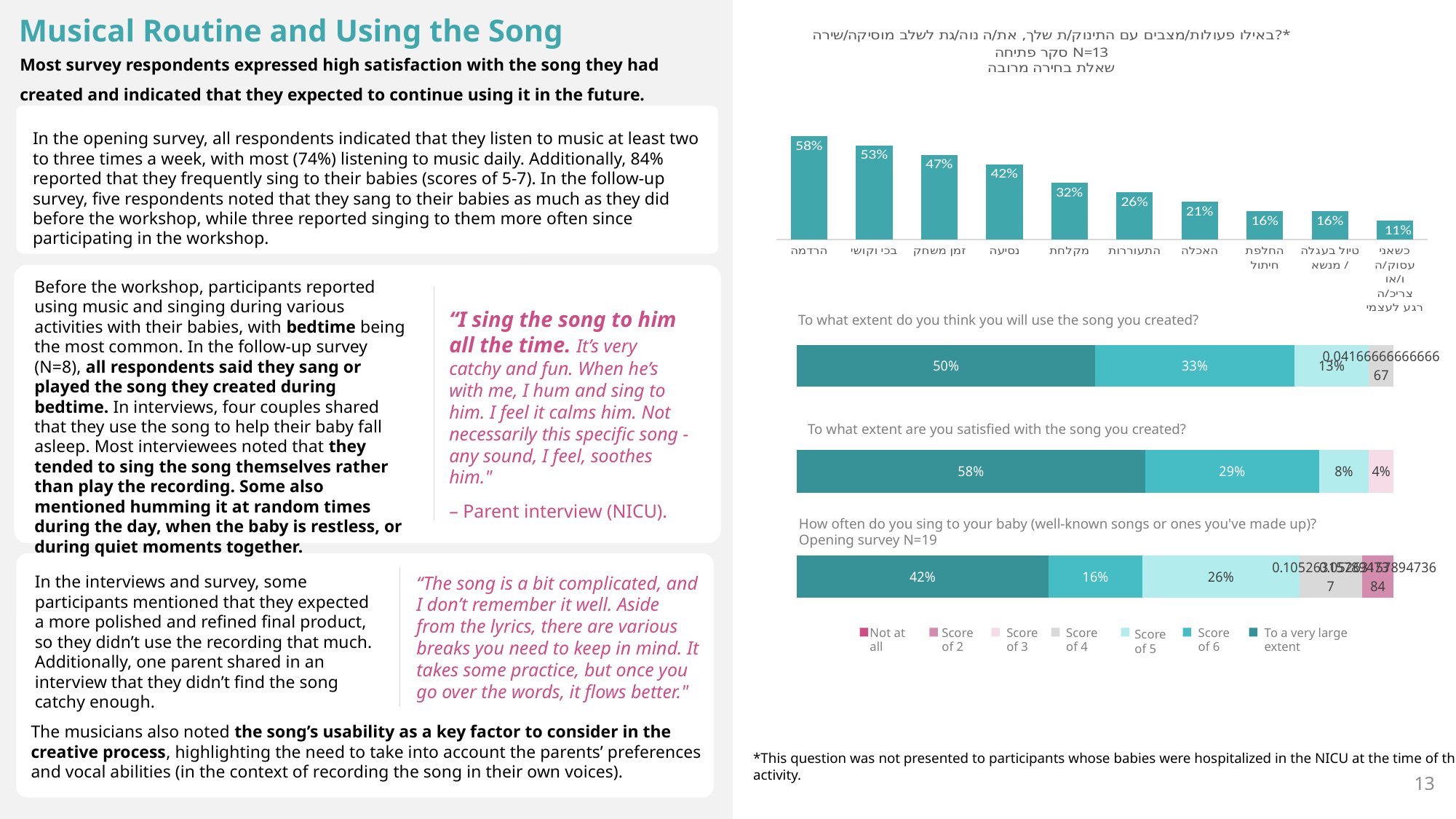
In the bar chart at the top right of the slide, what is the value of the tallest bar? 58% In the chart titled 'To what extent do you think you will use the song you created?', what is the value of the largest segment? 50% What kind of chart is the chart at the top right of the slide? bar chart In the chart titled 'To what extent are you satisfied with the song you created?', what is the value of the largest segment? 58% Do the values in the bar chart at the top right of the slide rise or fall from left to right? fall How many bars are shown in the bar chart at the top right of the slide? 10 In the bar chart at the top right of the slide, what is the value of the shortest bar? 11% In the bar chart at the top right of the slide, what is the difference between the first bar (58%) and the second bar (53%)? 5 percentage points In the chart titled 'To what extent do you think you will use the song you created?', what is the difference between the 50% segment and the 33% segment? 17 percentage points In the chart titled 'How often do you sing to your baby (well-known songs or ones you've made up)?', which is larger: the second segment (16%) or the third segment (26%)? the third segment (26%) How many entries does the legend below the stacked bar charts list? 7 In the chart titled 'To what extent are you satisfied with the song you created?', what is the value of the smallest labelled segment? 4%